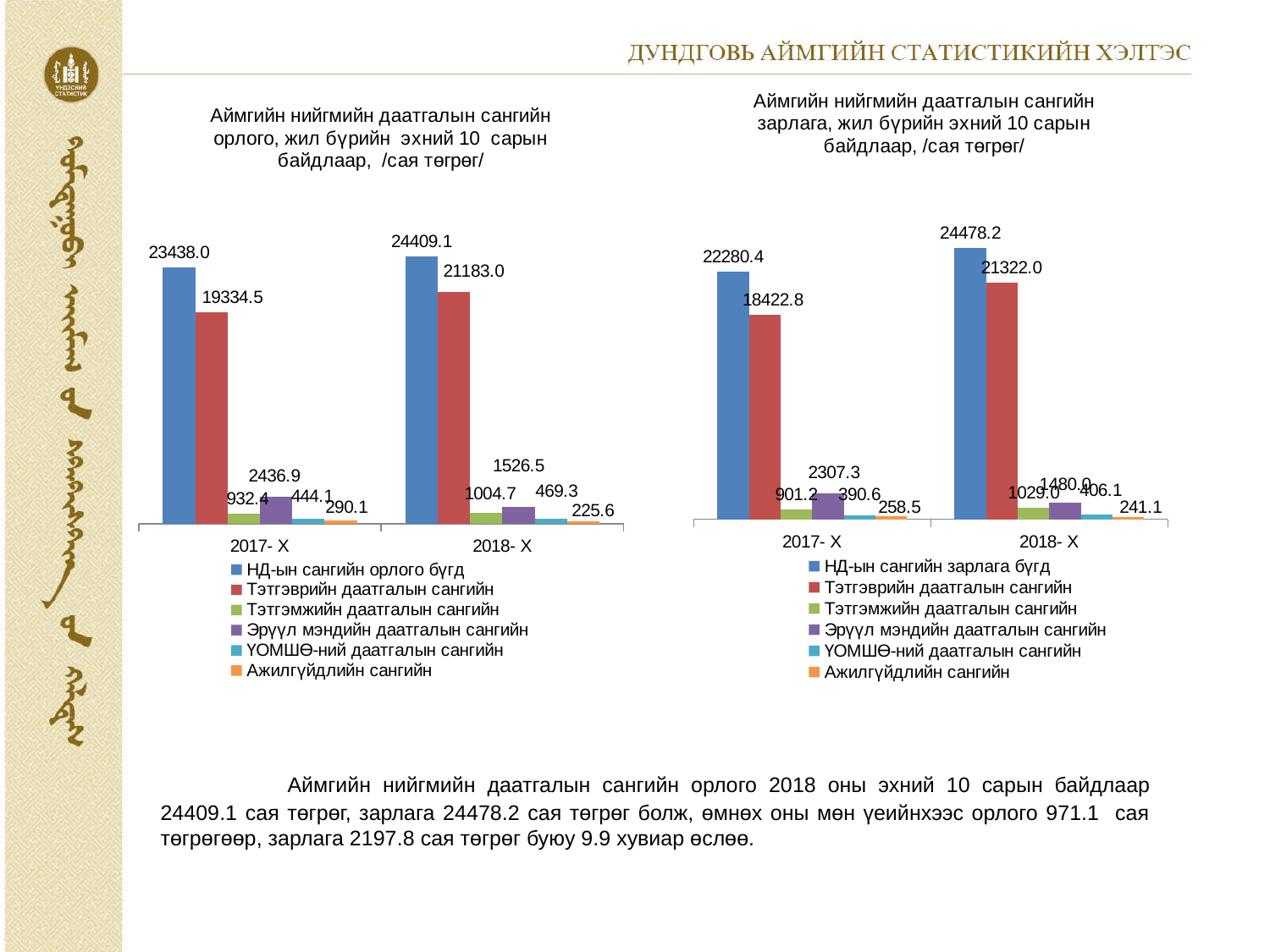
On the left chart (Аймгийн нийгмийн даатгалын сангийн орлого), what is the value of Тэтгэврийн даатгалын сангийн for 2017- X? 19334.5 On the right chart (Аймгийн нийгмийн даатгалын сангийн зарлага), what is the value of Эрүүл мэндийн даатгалын сангийн for 2017- X? 2307.3 On the left chart (Аймгийн нийгмийн даатгалын сангийн орлого), which series has the lowest value for 2018- X? Ажилгүйдлийн сангийн On the left chart (Аймгийн нийгмийн даатгалын сангийн орлого), what is the difference between НД-ын сангийн орлого бүгд in 2018- X and in 2017- X? 971.1 On the left chart (Аймгийн нийгмийн даатгалын сангийн орлого), is Эрүүл мэндийн даатгалын сангийн larger in 2017- X or in 2018- X? 2017- X On the right chart (Аймгийн нийгмийн даатгалын сангийн зарлага), which series has the highest value for 2017- X? НД-ын сангийн зарлага бүгд What type of chart is the right chart (Аймгийн нийгмийн даатгалын сангийн зарлага)? Bar chart On the left chart (Аймгийн нийгмийн даатгалын сангийн орлого), what is the value of НД-ын сангийн орлого бүгд for 2018- X? 24409.1 On the right chart (Аймгийн нийгмийн даатгалын сангийн зарлага), what is the value of НД-ын сангийн зарлага бүгд for 2018- X? 24478.2 How many series does the legend of the right chart (Аймгийн нийгмийн даатгалын сангийн зарлага) list? 6 On the right chart (Аймгийн нийгмийн даатгалын сангийн зарлага), what is the difference between НД-ын сангийн зарлага бүгд in 2018- X and in 2017- X? 2197.8 How many categories are shown on the x axis of the left chart (Аймгийн нийгмийн даатгалын сангийн орлого)? 2